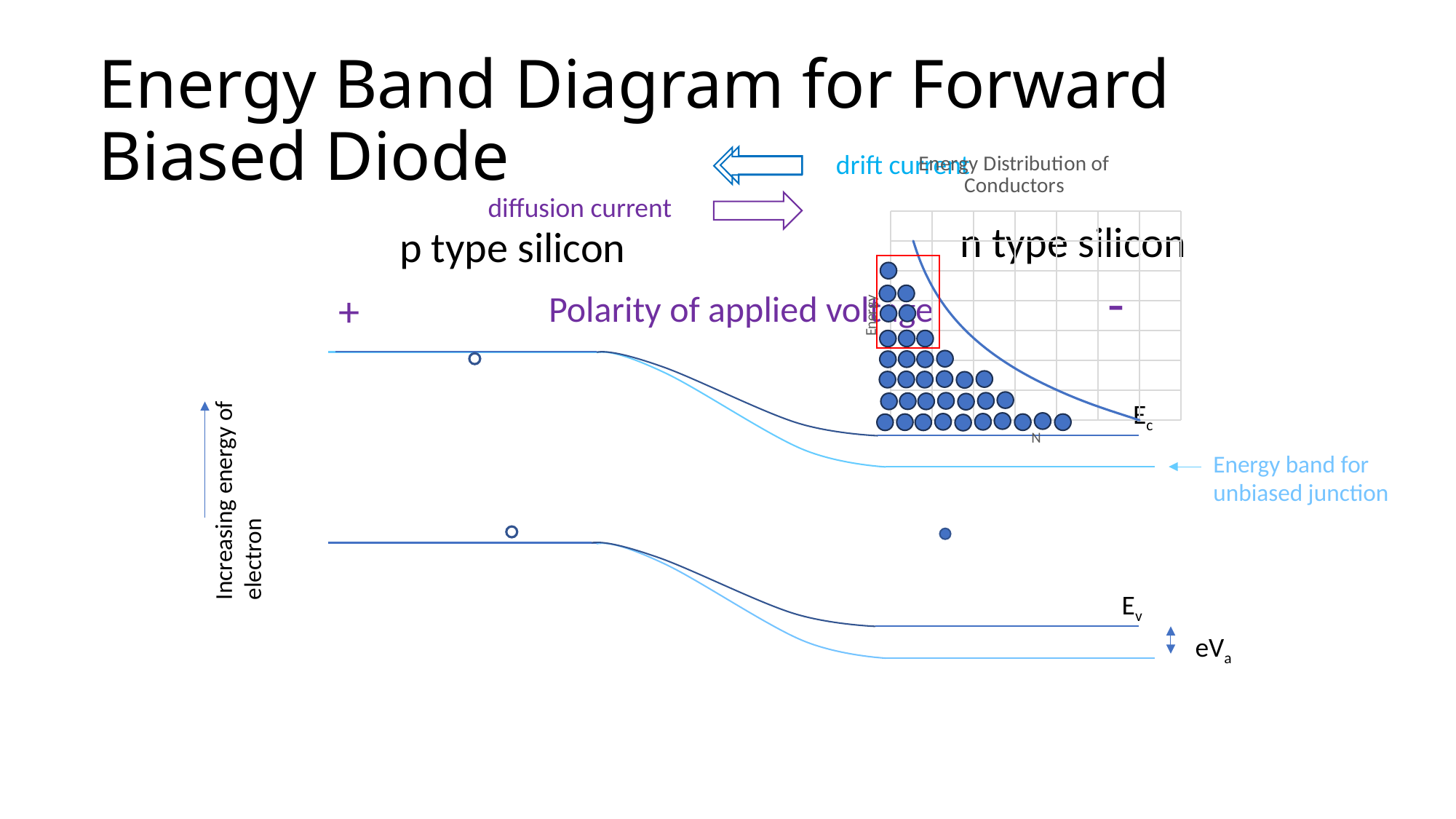
What kind of chart is the 'Energy Distribution of Conductors' chart? line chart What is the title of the chart embedded on the right side of the slide? Energy Distribution of Conductors In the 'Energy Distribution of Conductors' chart, does the plotted curve rise or fall as it moves along the x axis? fall In the 'Energy Distribution of Conductors' chart, what is the label on the vertical axis? Energy